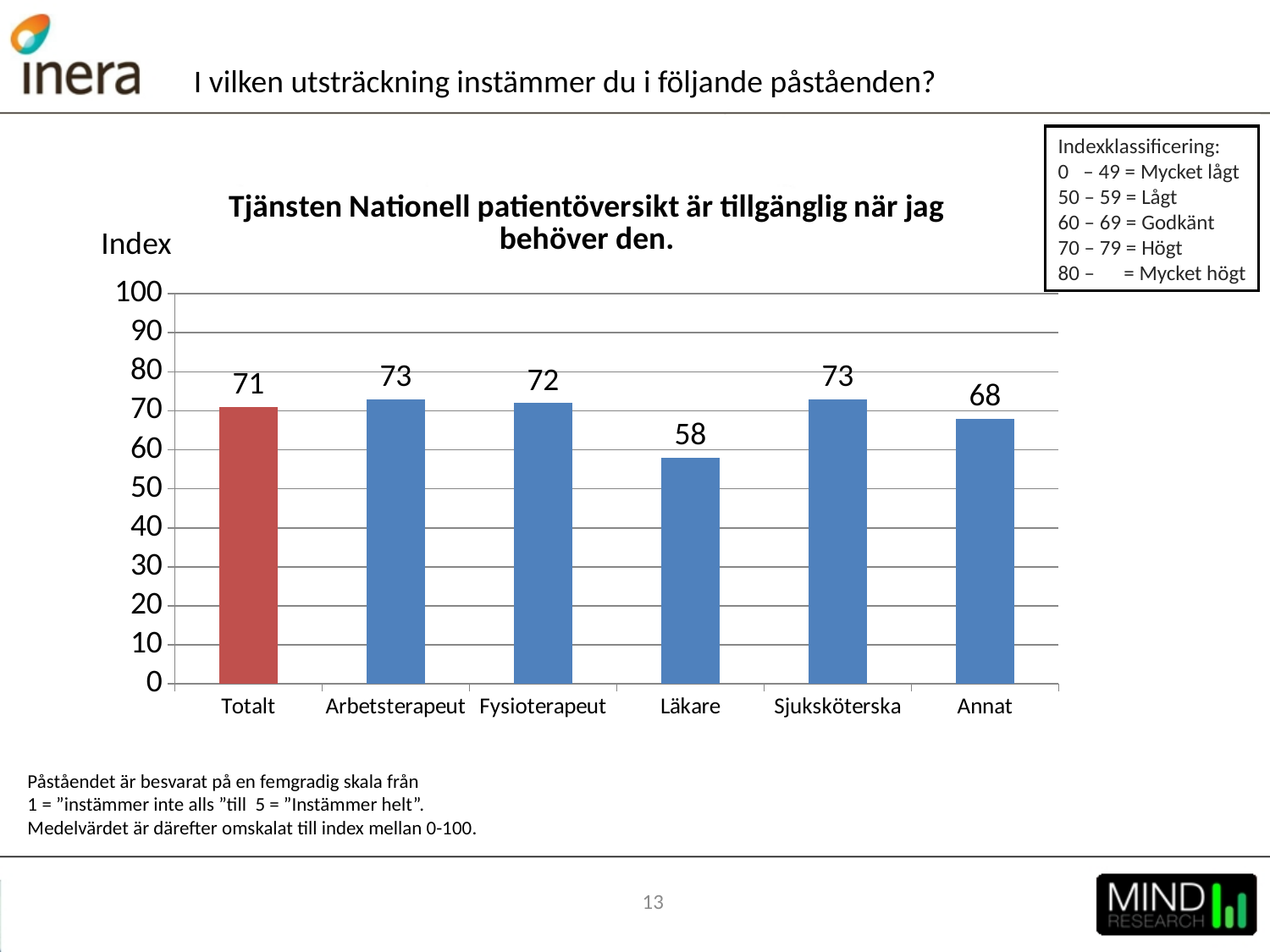
What is the index value for Läkare? 58 Which category has the lowest index value? Läkare How many categories are shown on the x axis? 6 Which is larger, the index value for Fysioterapeut or for Annat? Fysioterapeut What is the index value for Totalt? 71 Is the value for Läkare greater or less than 60? less What is the difference between the index values for Sjuksköterska and Läkare? 15 Which bar is coloured red rather than blue? Totalt What is the title of the chart? Tjänsten Nationell patientöversikt är tillgänglig när jag behöver den. What kind of chart is shown on the slide? bar chart What is the difference between the index values for Totalt and Annat? 3 What is the index value for Annat? 68